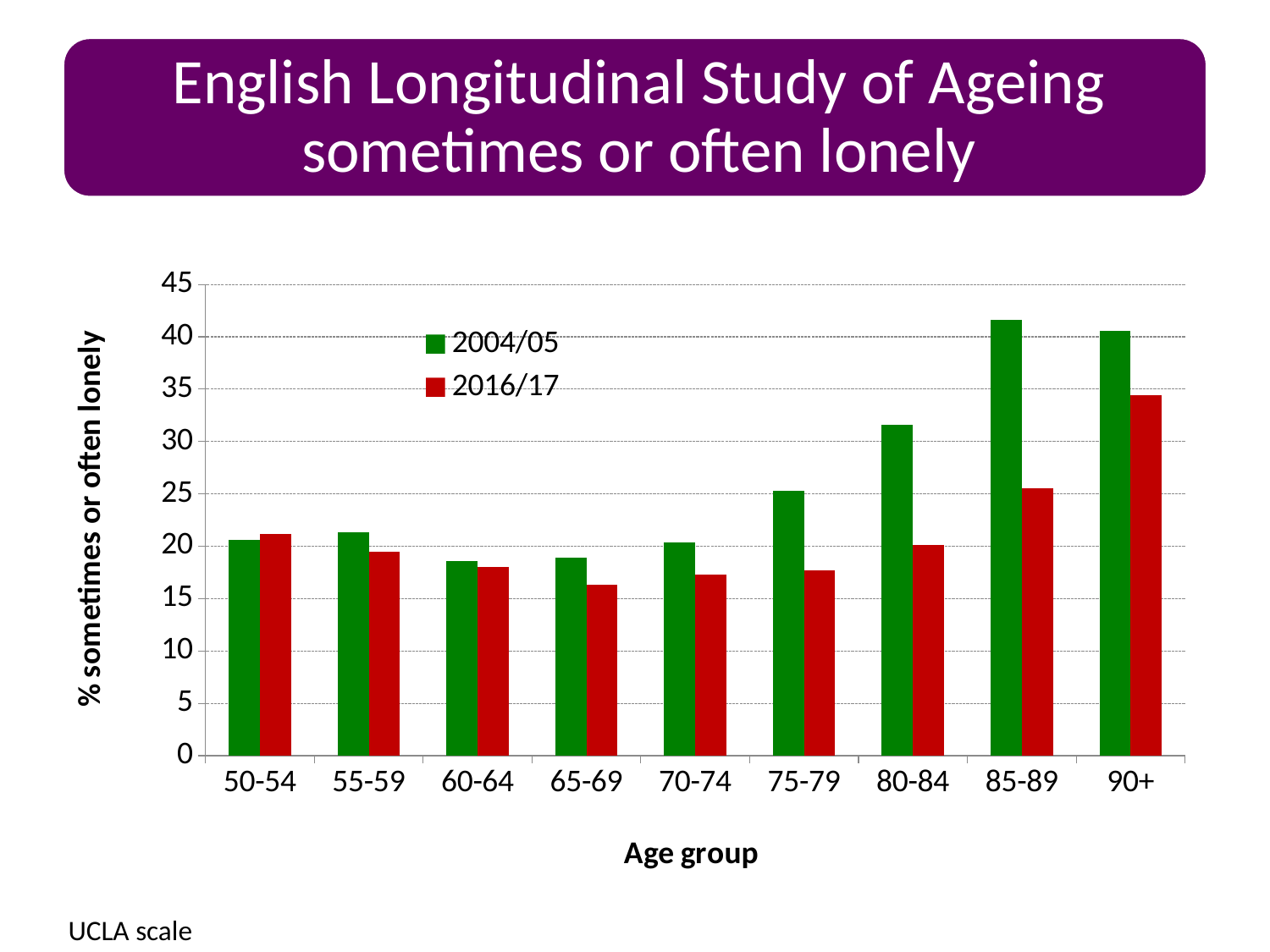
Do the 2016/17 values rise or fall from the 65-69 age group to the 90+ age group? rise How many age groups are shown on the x axis? 9 Which age group has the lowest value for 2016/17? 65-69 Which age group has the highest value for 2016/17? 90+ How many series does the legend list? 2 What kind of chart is shown on the slide? bar chart Is the 2016/17 value for the 65-69 age group greater or less than 20? less Is the 2004/05 value for the 80-84 age group greater or less than 30? greater What is the label of the y axis? % sometimes or often lonely Is the 2004/05 value for the 85-89 age group greater or less than 40? greater For the 85-89 age group, which series has the larger value, 2004/05 or 2016/17? 2004/05